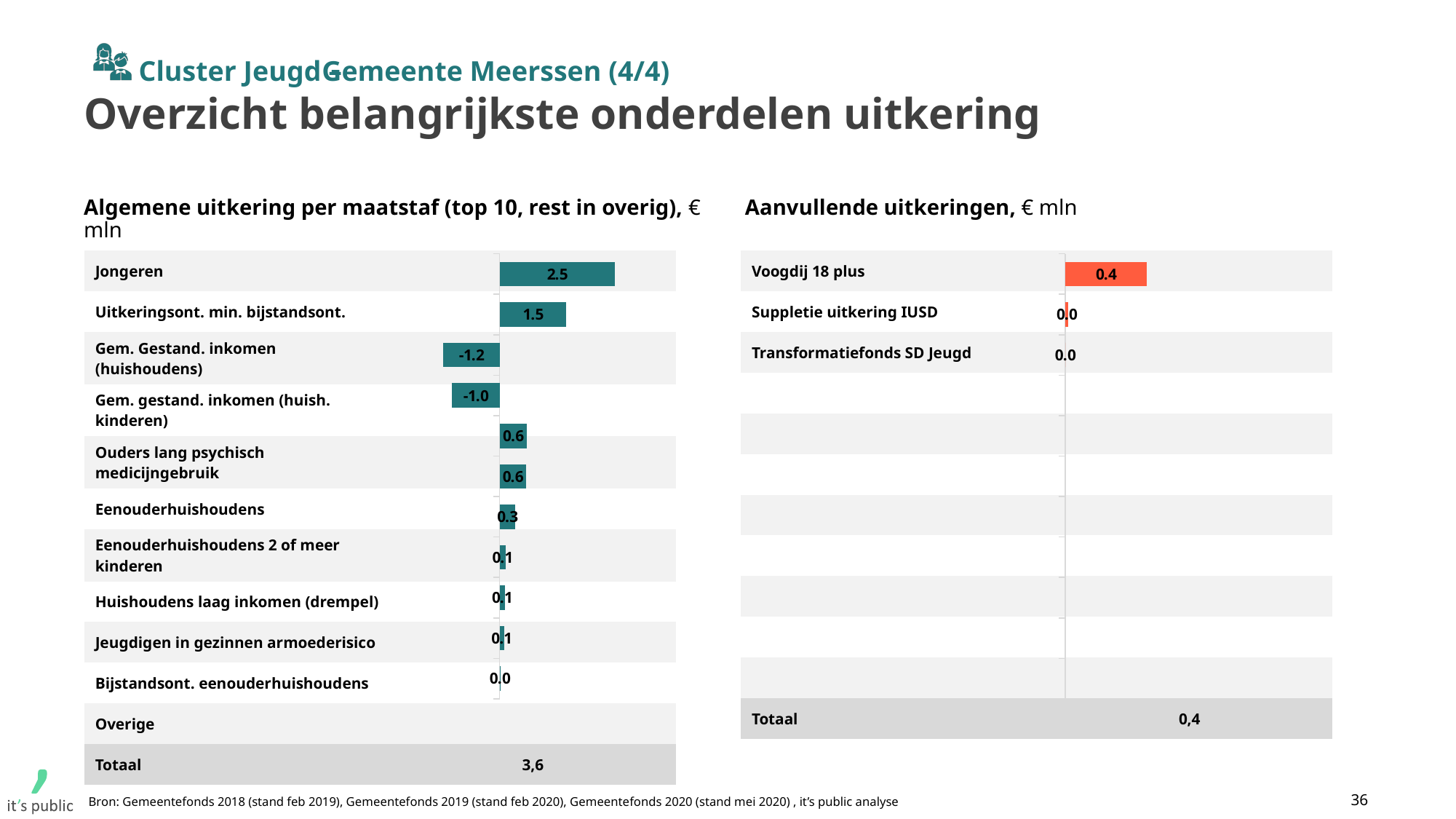
In the 'Algemene uitkering per maatstaf' chart, which category has the lowest value? Gem. Gestand. inkomen (huishoudens) In the 'Aanvullende uitkeringen' chart, what is the value for Voogdij 18 plus? 0.4 In the 'Algemene uitkering per maatstaf' chart, what is the value for Gem. Gestand. inkomen (huishoudens)? -1.2 In the 'Algemene uitkering per maatstaf' chart, what is the value for Gem. gestand. inkomen (huish. kinderen)? -1.0 In the 'Algemene uitkering per maatstaf' chart, what is the Totaal shown at the bottom? 3,6 What kind of chart is the 'Aanvullende uitkeringen' chart? Bar chart In the 'Algemene uitkering per maatstaf' chart, what is the difference between the values for Jongeren and Uitkeringsont. min. bijstandsont.? 1.0 In the 'Aanvullende uitkeringen' chart, what is the value for Transformatiefonds SD Jeugd? 0.0 In the 'Algemene uitkering per maatstaf' chart, what is the value for Uitkeringsont. min. bijstandsont.? 1.5 In the 'Algemene uitkering per maatstaf' chart, which category has the highest value? Jongeren In the 'Algemene uitkering per maatstaf' chart, what is the value for Jongeren? 2.5 How many categories are plotted in the 'Aanvullende uitkeringen' chart? 3